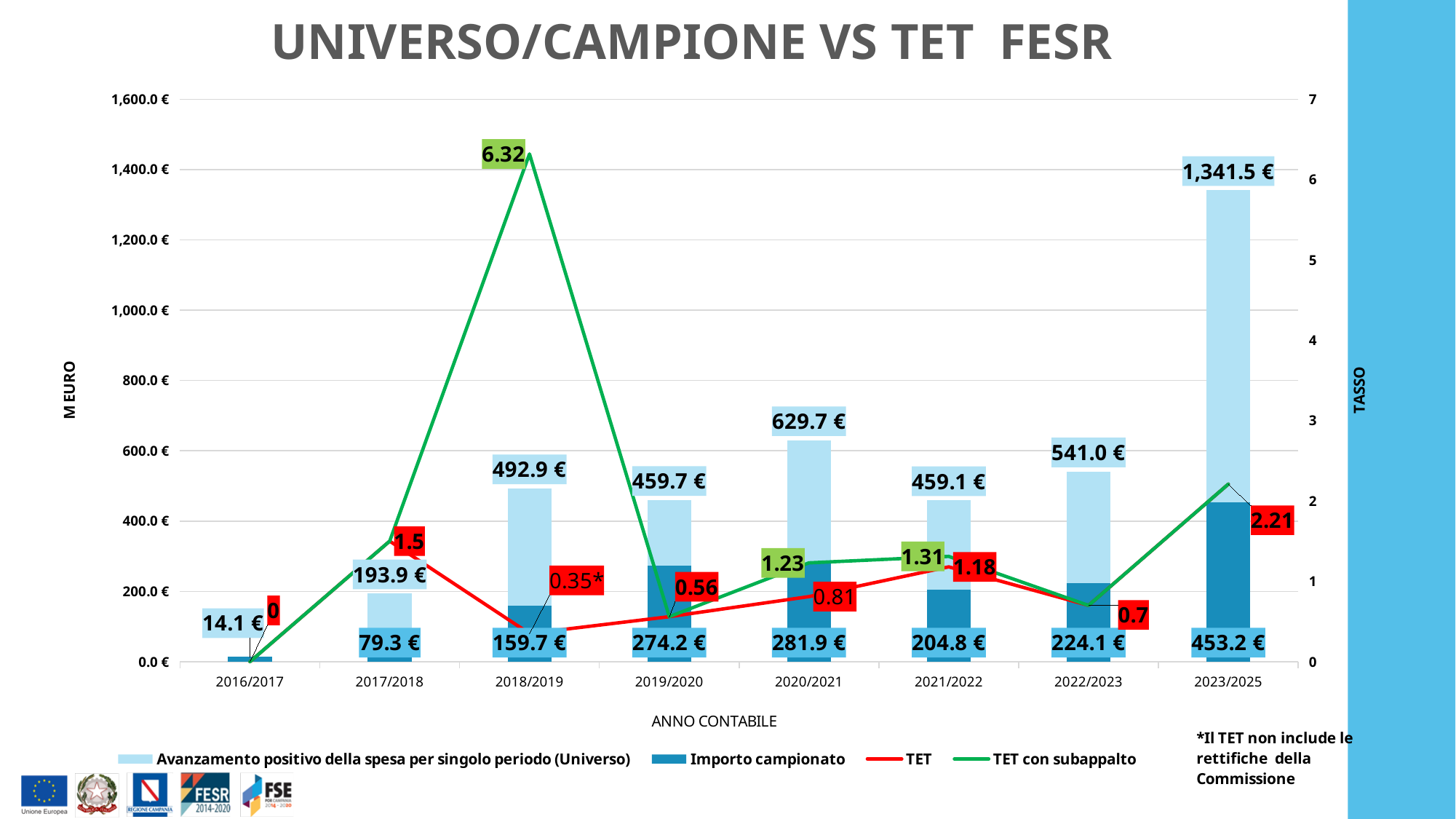
Which is larger, the 'Universo' value for 2020/2021 or for 2022/2023? 2020/2021 How many accounting years are shown on the x axis? 8 What is the 'TET con subappalto' value for 2018/2019? 6.32 Which accounting year has the highest TET value? 2023/2025 Which accounting year has the highest 'Universo' bar? 2023/2025 What is the title of the x axis? ANNO CONTABILE What is the value of 'Avanzamento positivo della spesa per singolo periodo (Universo)' for 2023/2025? 1,341.5 € Which accounting year has the lowest 'Universo' bar? 2016/2017 How many series does the legend list? 4 What is the difference between the 'Universo' value and the 'Importo campionato' value for 2020/2021? 347.8 € What is the TET value for 2017/2018? 1.5 What is the 'Importo campionato' value for 2019/2020? 274.2 €